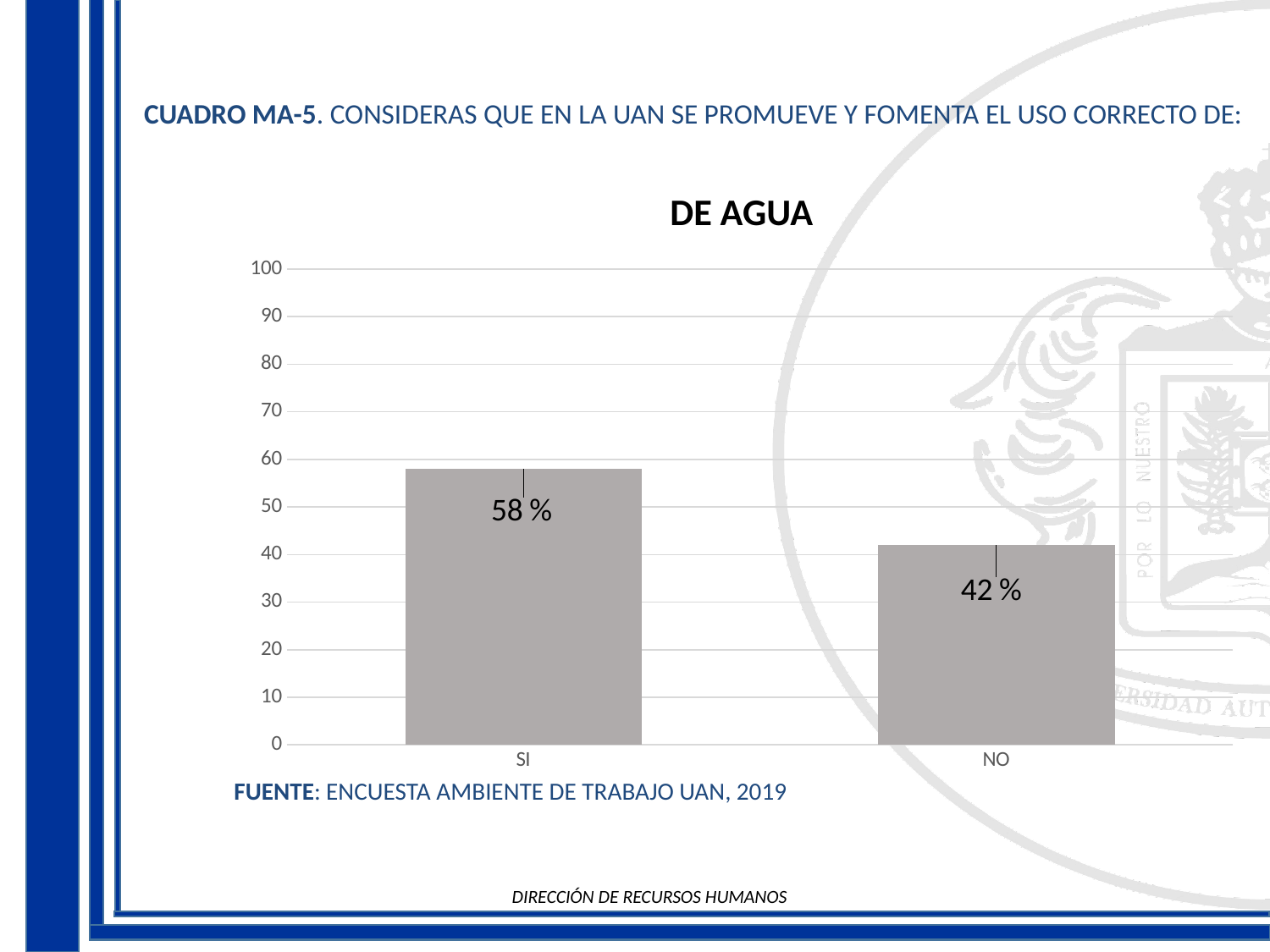
Which is larger, the value for SI or the value for NO? SI What is the maximum value shown on the y axis? 100 Is the value for SI greater or less than 50? greater How many categories are shown on the x axis? 2 Which category has the highest value? SI What is the difference between the values for SI and NO? 16 % What is the value for NO? 42 % Which category has the lowest value? NO Is the value for NO greater or less than 50? less What is the value for SI? 58 % What is the title of the chart? DE AGUA What kind of chart is shown? bar chart